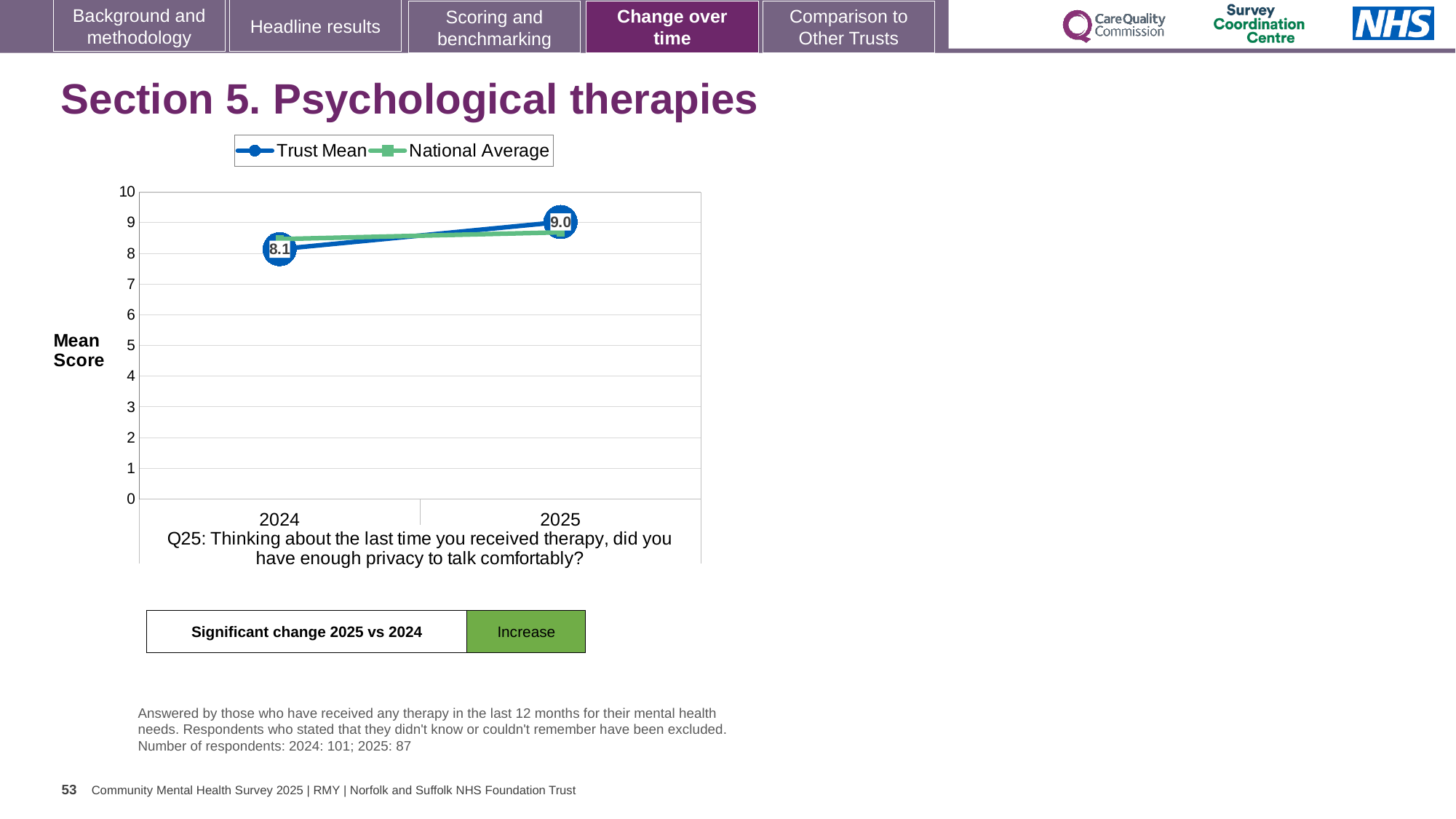
How many years are shown on the x axis? 2 How many series does the legend list? 2 What is the Trust Mean score for 2024? 8.1 In which year is the Trust Mean score higher? 2025 In 2024, which is higher: the Trust Mean or the National Average? National Average Does the Trust Mean rise or fall from 2024 to 2025? rise What is the Trust Mean score for 2025? 9.0 What kind of chart is shown on the slide? line chart By how much did the Trust Mean score change from 2024 to 2025? 0.9 In which year is the Trust Mean score lower? 2024 Is the National Average value for 2025 greater or less than 9? less Is the National Average value for 2024 greater or less than 8? greater